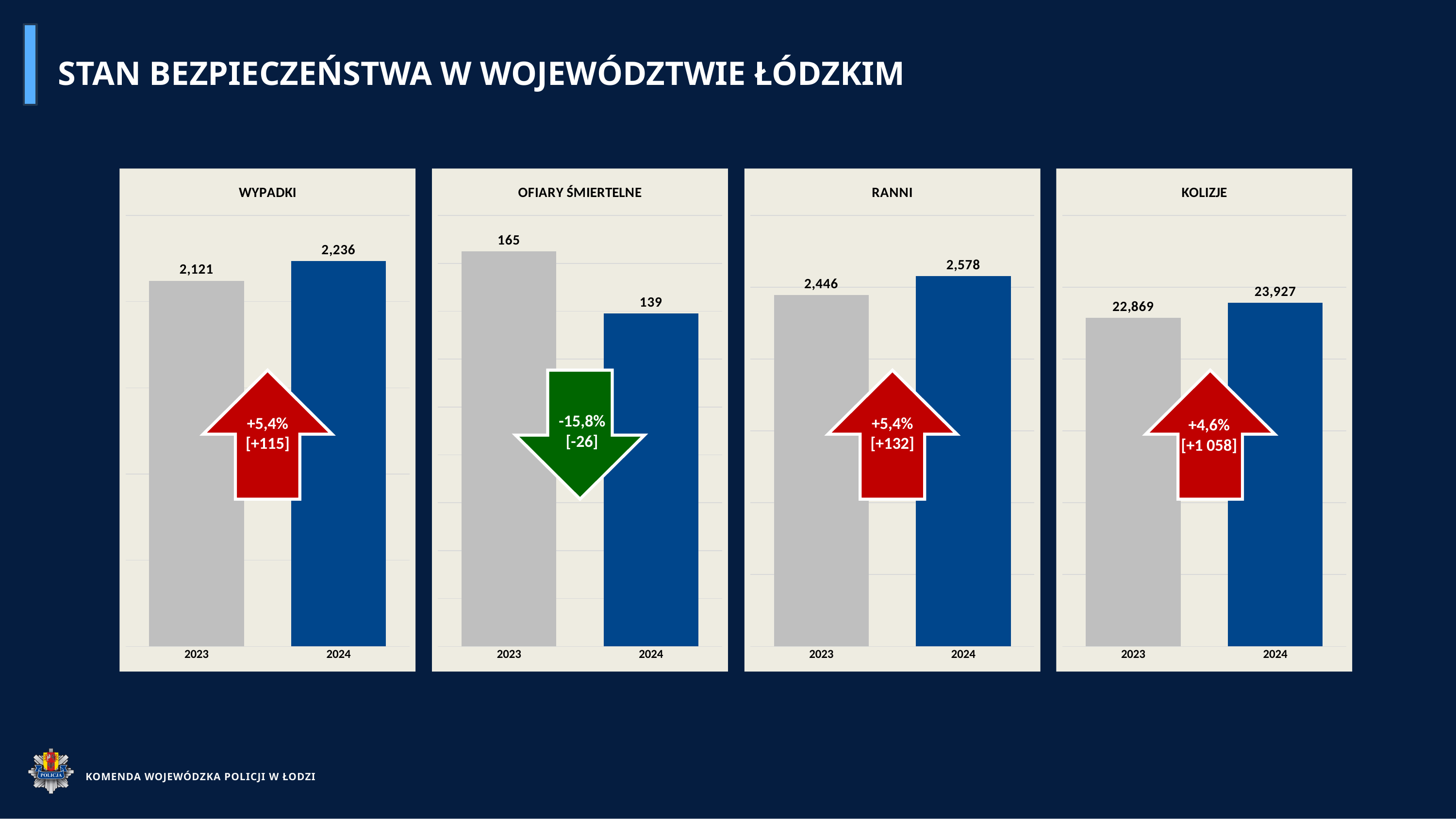
What kind of chart is the RANNI chart? bar chart In the WYPADKI chart, what is the value for 2023? 2,121 In the OFIARY ŚMIERTELNE chart, what is the difference between the 2023 and 2024 values? 26 How many bars does the KOLIZJE chart have? 2 In the RANNI chart, what is the difference between the 2024 and 2023 values? 132 In the OFIARY ŚMIERTELNE chart, which year has the higher value? 2023 In the WYPADKI chart, is the value for 2024 larger or smaller than the value for 2023? larger In the WYPADKI chart, what is the value for 2024? 2,236 In the OFIARY ŚMIERTELNE chart, what is the value for 2024? 139 In the KOLIZJE chart, what is the value for 2024? 23,927 In the KOLIZJE chart, which year has the lower value? 2023 In the RANNI chart, what is the value for 2023? 2,446